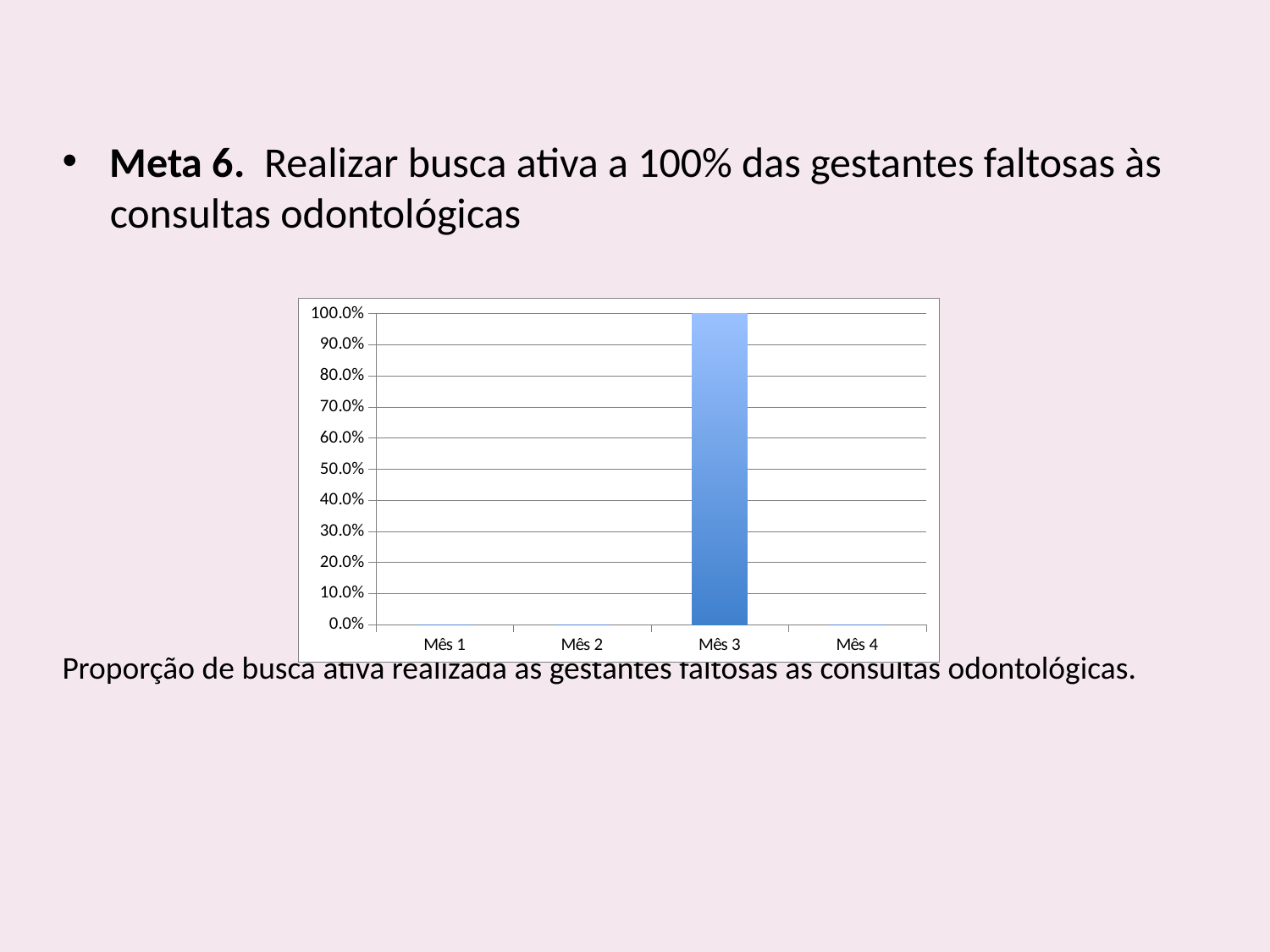
How many categories are shown on the x axis of the chart? 4 What is the caption printed below the chart? Proporção de busca ativa realizada as gestantes faltosas as consultas odontológicas. Which month has the highest value in the chart? Mês 3 Is the value for Mês 3 greater or less than 50.0%? greater What is the difference between the value for Mês 3 and the value for Mês 2? 100.0% Is the value for Mês 2 greater or less than 10.0%? less What is the value for Mês 3 in the chart? 100.0% Which is larger, the value for Mês 3 or the value for Mês 4? Mês 3 What kind of chart is shown on the slide? bar chart What is the highest value shown on the y axis of the chart? 100.0% What is the value for Mês 1 in the chart? 0.0% What is the value for Mês 4 in the chart? 0.0%